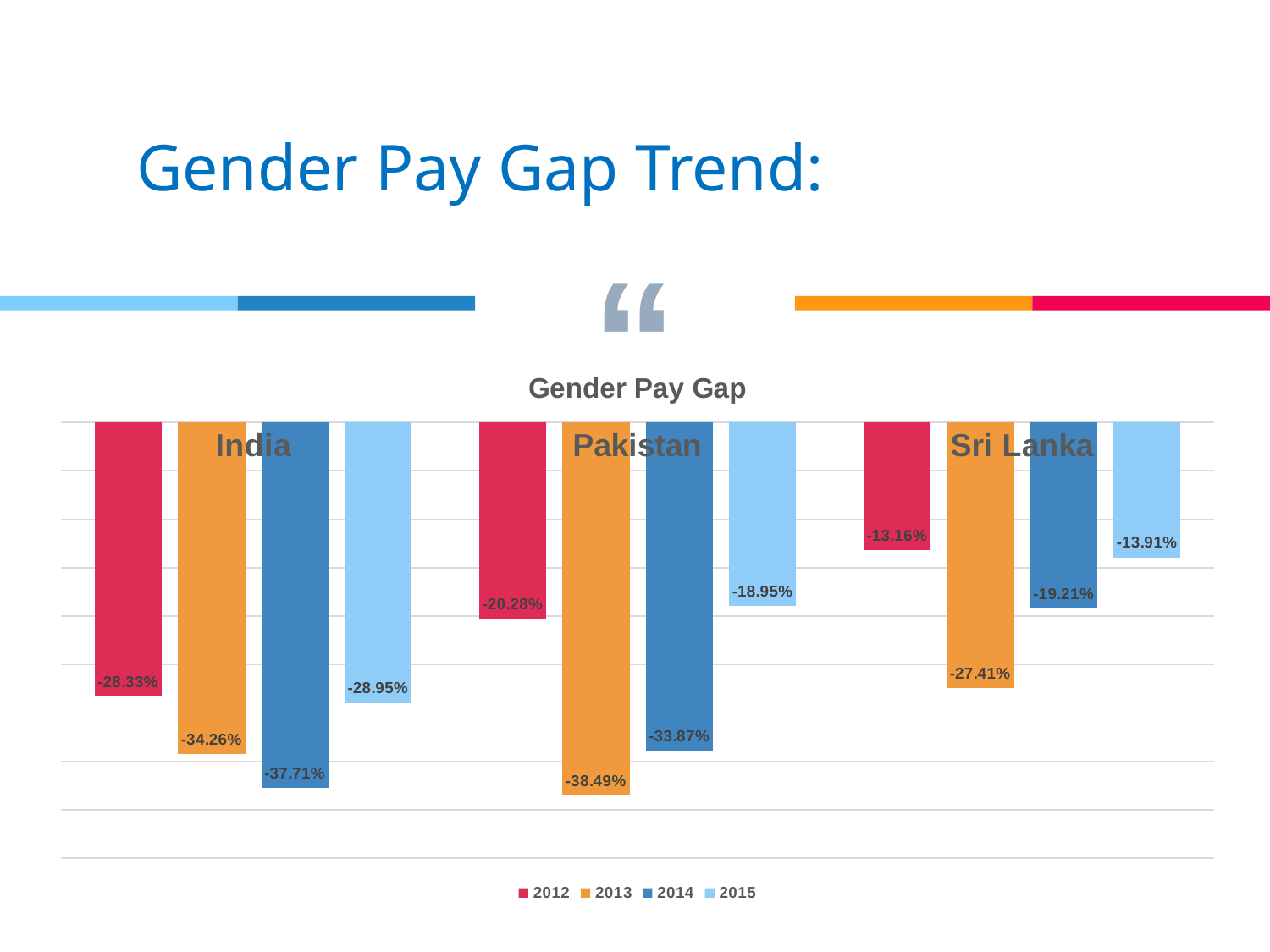
What is the value for Sri Lanka in 2012? -13.16% Which year has the lowest (most negative) value for Pakistan? 2013 How many series does the legend list? 4 Which year has the highest (least negative) value for Sri Lanka? 2012 Which country has the lowest (most negative) value in 2014? India What is the value for India in 2014? -37.71% What kind of chart is this? Bar chart What is the difference between the 2013 and 2012 values for India? 5.93 percentage points What is the value for Pakistan in 2015? -18.95% What is the value for Pakistan in 2013? -38.49% How many countries are shown on the x axis? 3 Which is larger (less negative): the 2015 value for India or the 2015 value for Sri Lanka? Sri Lanka